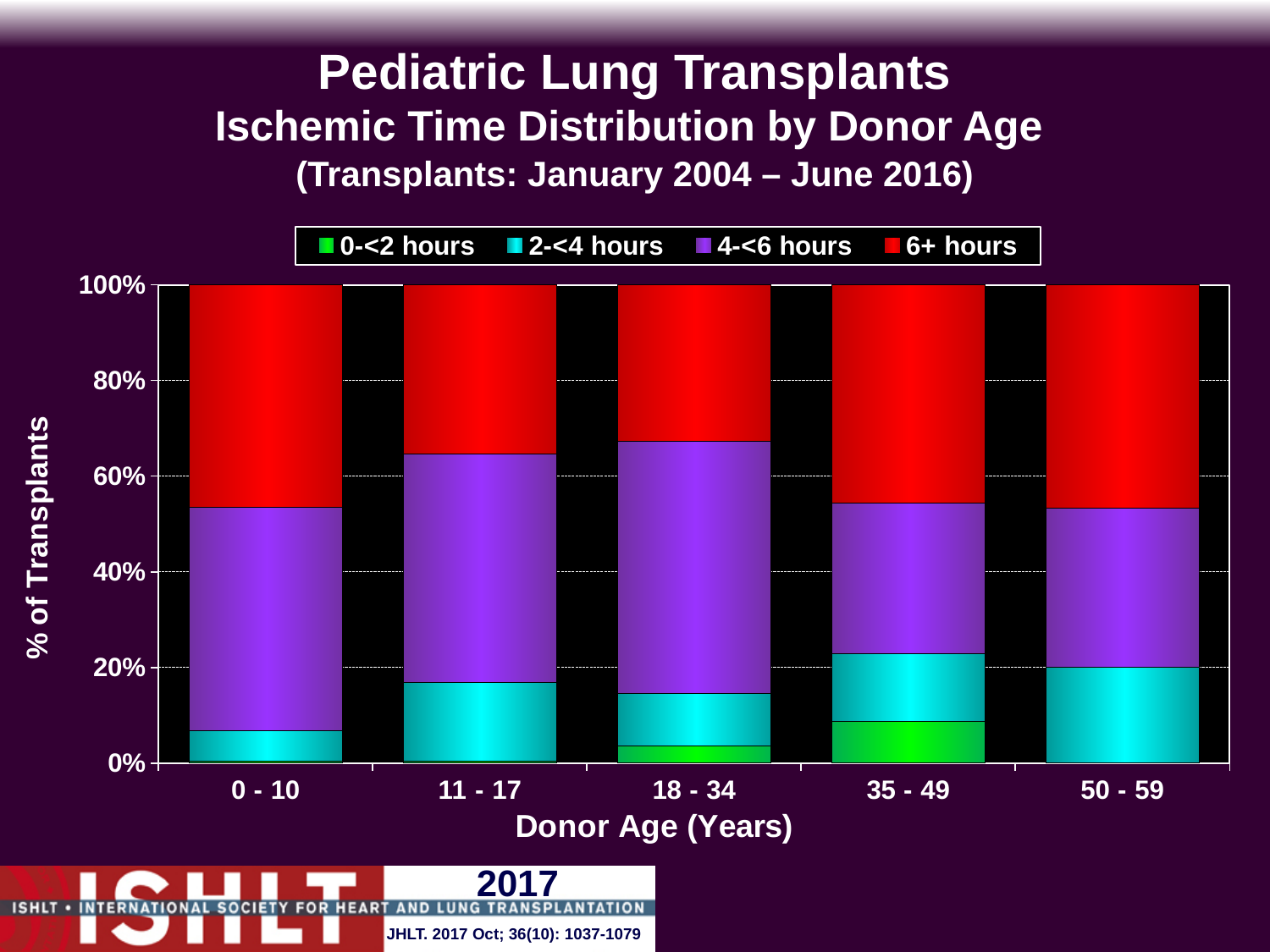
How many series does the legend list? 4 Is the 6+ hours share for the 18 - 34 donor age group greater or less than 40%? less What kind of chart is shown on the slide? Stacked bar chart What is the total of the stacked bar for the 0 - 10 donor age group? 100% Is the 4-<6 hours share for the 18 - 34 donor age group greater or less than 40%? greater Which is larger, the 2-<4 hours share for the 11 - 17 group or for the 0 - 10 group? 11 - 17 Is the 2-<4 hours share for the 0 - 10 donor age group greater or less than 20%? less Which is larger, the 6+ hours share for the 0 - 10 group or for the 18 - 34 group? 0 - 10 What is the label of the y axis? % of Transplants How many donor age groups are shown on the x axis? 5 Which donor age group has the largest 0-<2 hours share? 35 - 49